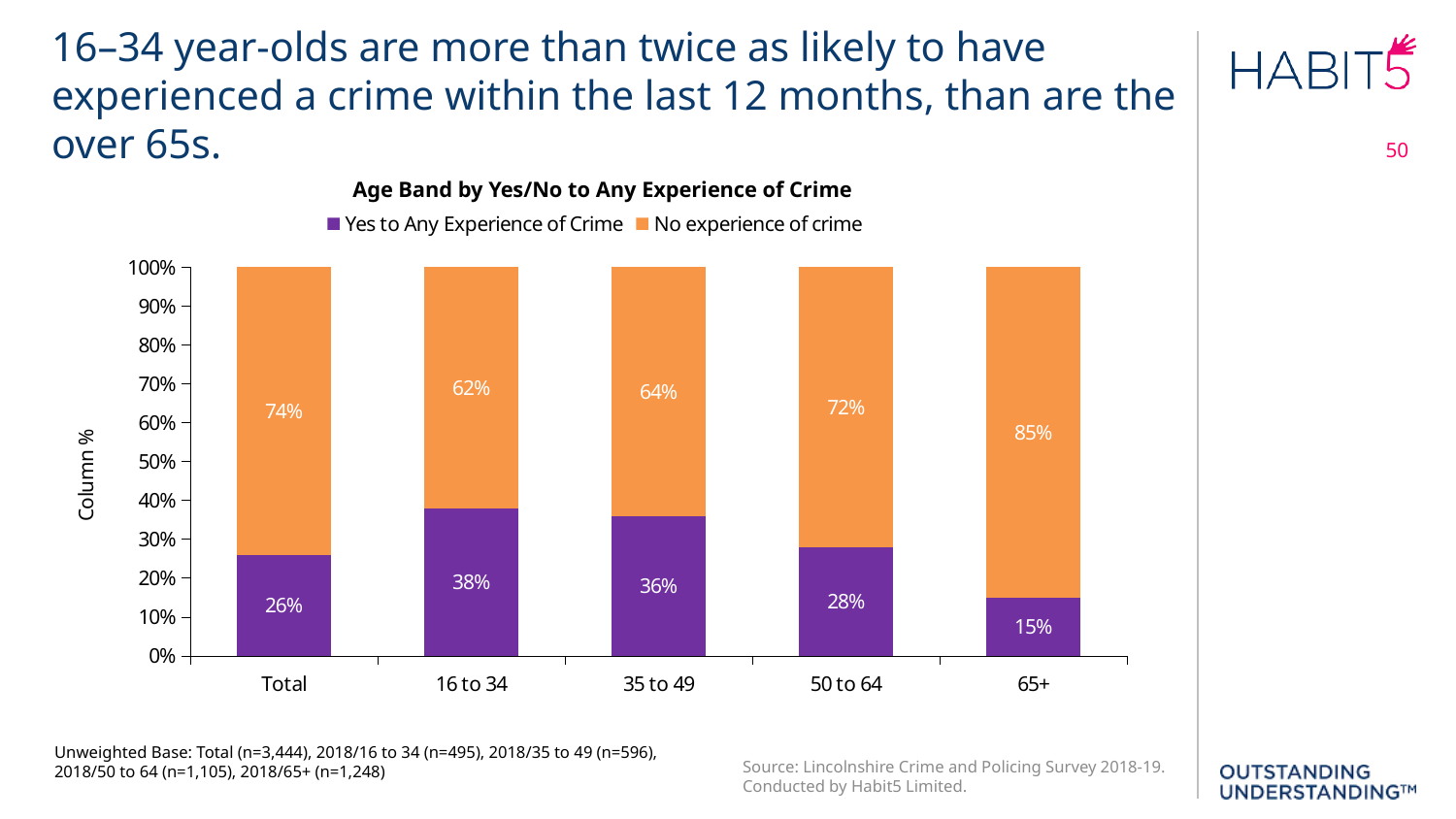
How many categories are shown on the x axis? 5 What kind of chart is shown on the slide? Stacked bar chart What is the value for Yes to Any Experience of Crime for the Total category? 26% What is the value for No experience of crime in the 65+ age band? 85% What is the difference between the Yes to Any Experience of Crime values for 16 to 34 and 65+? 23% What is the total of the stacked bar for the 50 to 64 age band? 100% How many series does the legend list? 2 Which age band has the highest value for Yes to Any Experience of Crime? 16 to 34 What percentage of 16 to 34 year-olds said Yes to Any Experience of Crime? 38% Which category has the lowest value for Yes to Any Experience of Crime? 65+ Which is larger: the No experience of crime value for 35 to 49 or for 50 to 64? 50 to 64 What is the title of the chart? Age Band by Yes/No to Any Experience of Crime